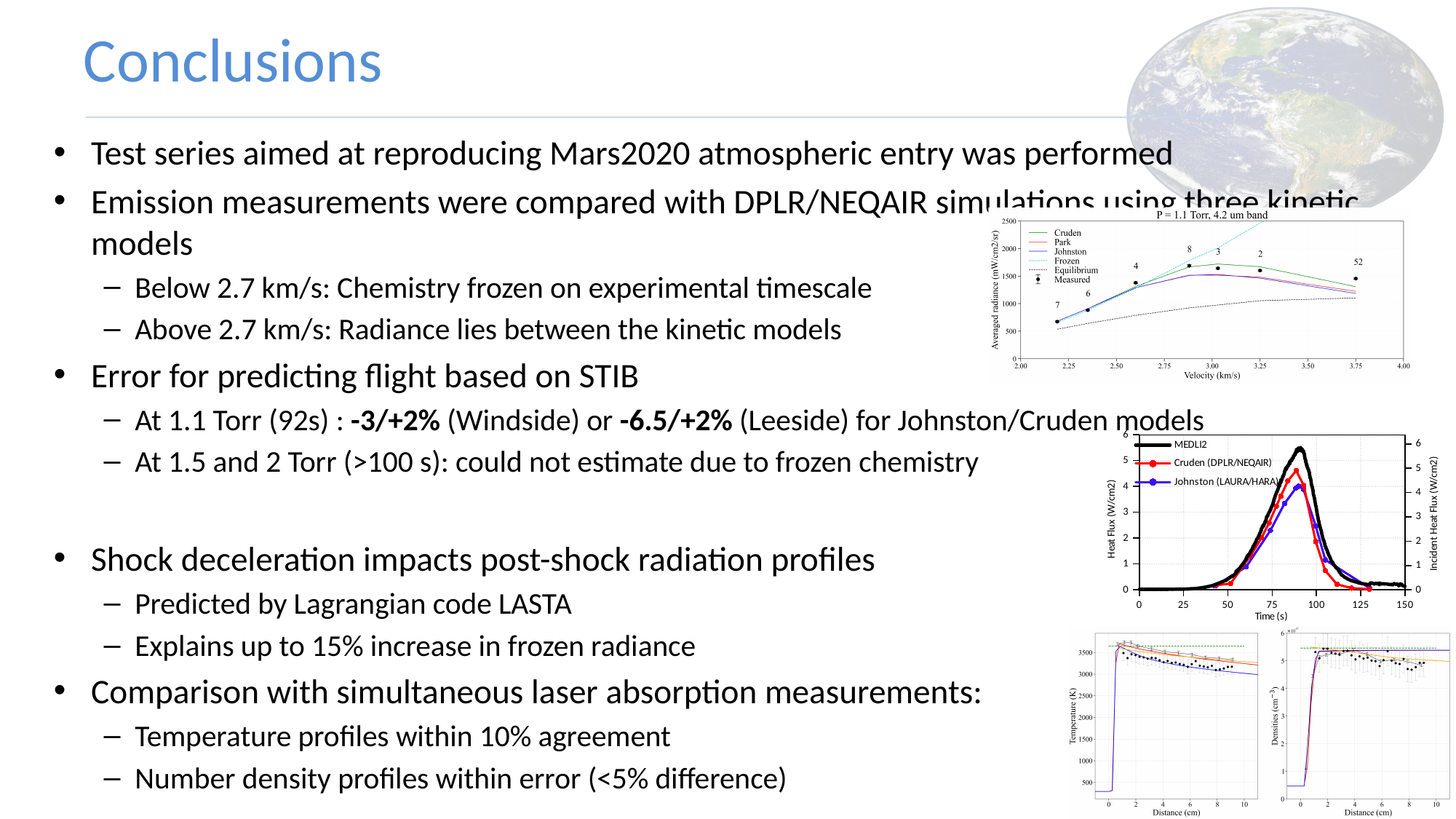
In the middle-right heat flux chart, which series reaches the highest peak heat flux? MEDLI2 In the middle-right heat flux chart, which is larger at its peak: the Cruden (DPLR/NEQAIR) curve or the Johnston (LAURA/HARA) curve? Cruden (DPLR/NEQAIR) In the top-right chart titled "P = 1.1 Torr, 4.2 um band", what quantity is plotted on the x axis? Velocity (km/s) In the middle-right heat flux chart, how many series does the legend list? 3 In the top-right chart titled "P = 1.1 Torr, 4.2 um band", is the measured radiance at about 3.75 km/s greater or less than 1000 mW/cm2/sr? greater In the middle-right heat flux chart, which series has the lowest peak heat flux? Johnston (LAURA/HARA) In the top-right chart titled "P = 1.1 Torr, 4.2 um band", is the measured radiance at the lowest velocity (about 2.2 km/s) greater or less than 1000 mW/cm2/sr? less In the middle-right heat flux chart, is the peak value of the MEDLI2 curve greater or less than 5 W/cm2? greater In the top-right chart titled "P = 1.1 Torr, 4.2 um band", how many entries does the legend list? 6 In the top-right chart titled "P = 1.1 Torr, 4.2 um band", which legend series is drawn as a dotted line that rises steeply above the others at high velocity? Frozen What kind of chart is the middle-right heat flux chart? Line chart